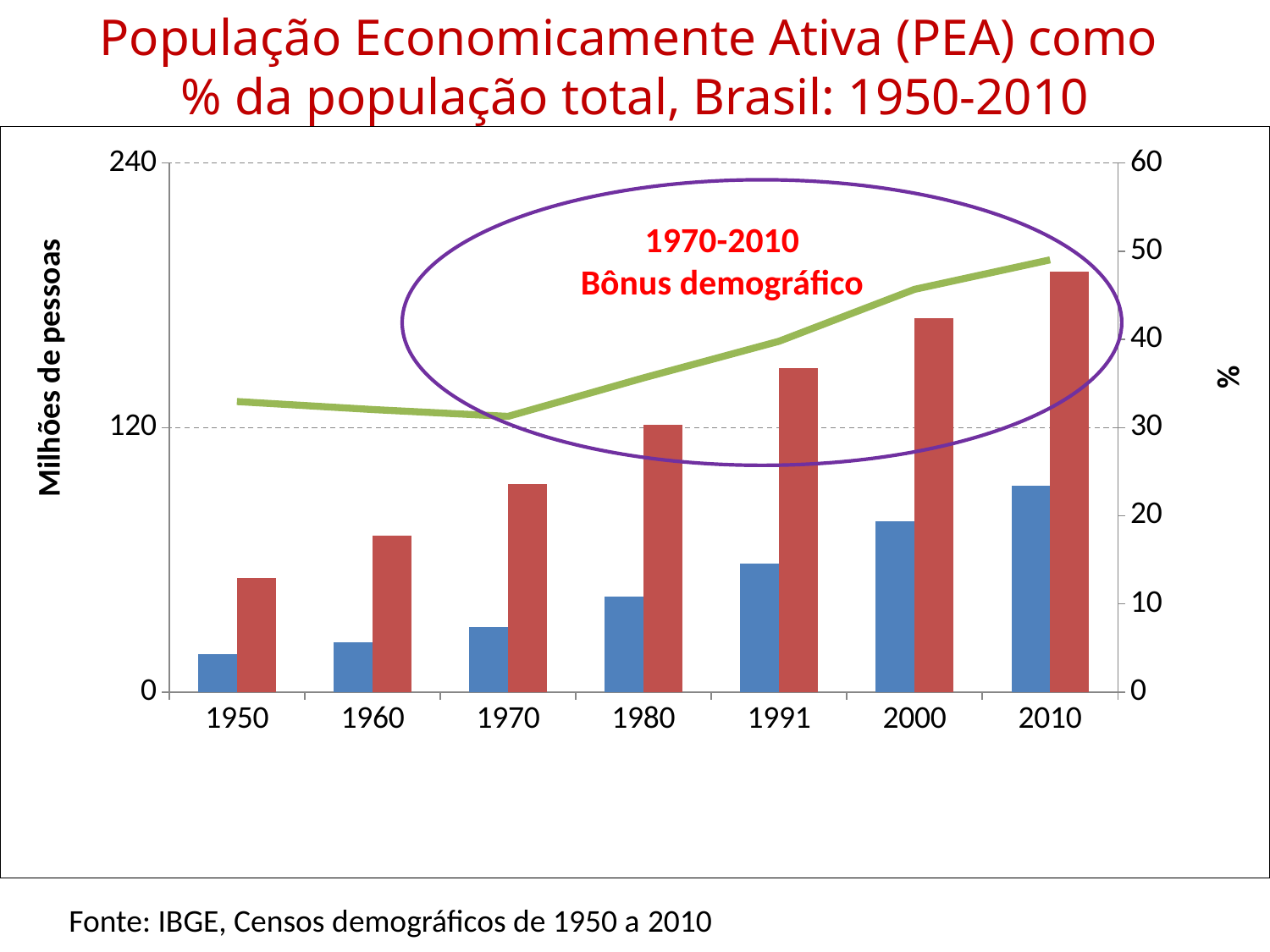
Is the value of the red bar for 1970 greater or less than 120 million people? less In 2010, which bar is taller, the blue bar or the red bar? the red bar Do the red bars rise or fall from 1950 to 2010? rise Is the green line's value for 2010 greater or less than 40%? greater What text is written inside the purple ellipse on the chart? 1970-2010 Bônus demográfico Is the value of the blue bar for 2010 greater or less than 120 million people? less In which year is the blue bar the tallest? 2010 In which year is the red bar the tallest? 2010 How many years are shown on the x axis of the chart? 7 What kind of chart is this? Bar chart with a line In which year is the red bar the shortest? 1950